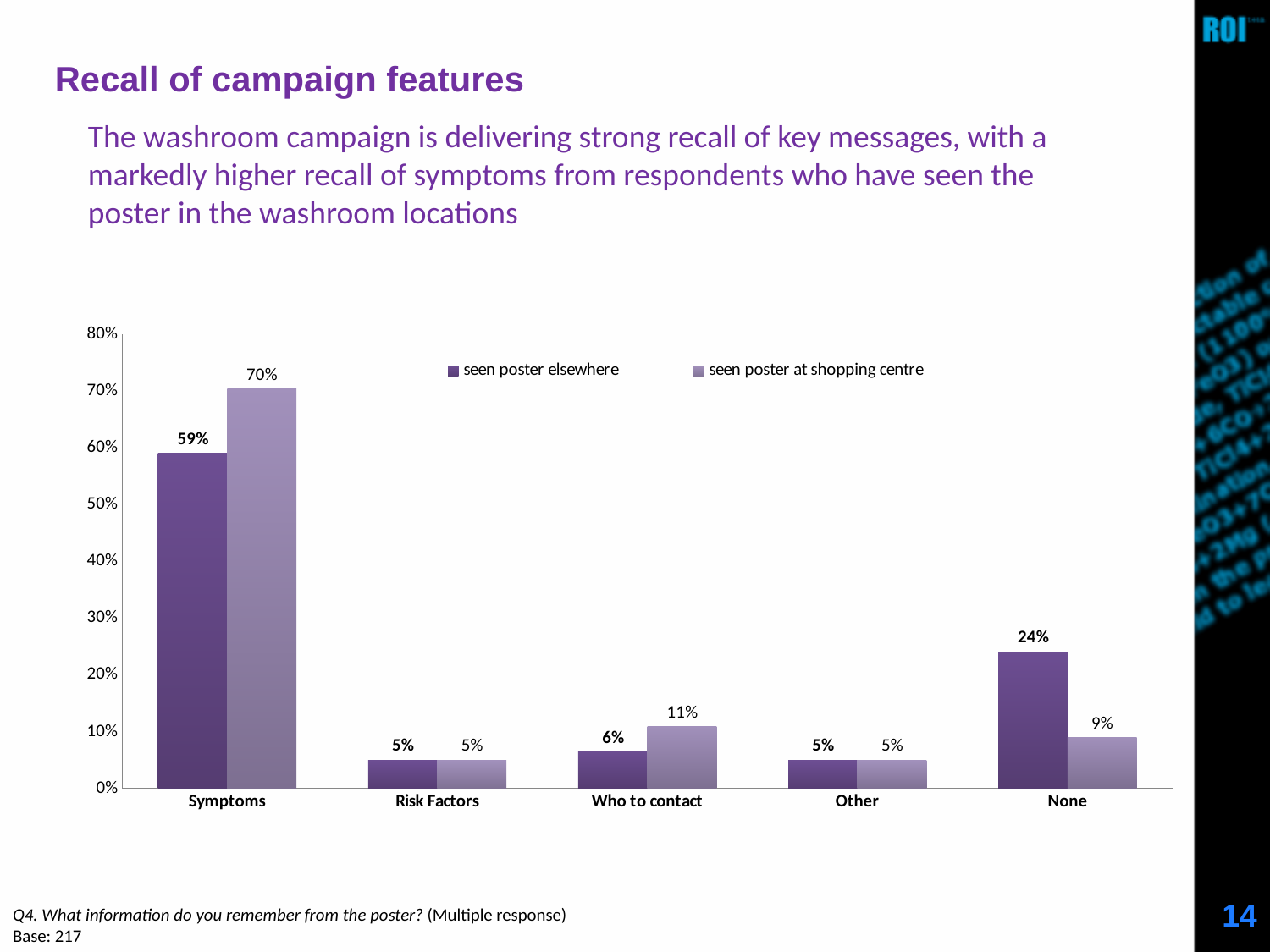
Which category has the highest value in the 'seen poster elsewhere' series? Symptoms Which category has the lowest value in the 'seen poster at shopping centre' series? Risk Factors and Other (both 5%) What is the difference between the two series for None? 15 percentage points How many series does the legend list? 2 What kind of chart is shown on the slide? bar chart What is the difference between the two series for Symptoms? 11 percentage points What is the value for Who to contact in the 'seen poster at shopping centre' series? 11% What is the value for Symptoms in the 'seen poster at shopping centre' series? 70% How many categories are shown on the x axis? 5 What is the value for None in the 'seen poster elsewhere' series? 24% Is the value for Symptoms in the 'seen poster elsewhere' series greater or less than 50%? greater For Who to contact, which series has the larger value? seen poster at shopping centre